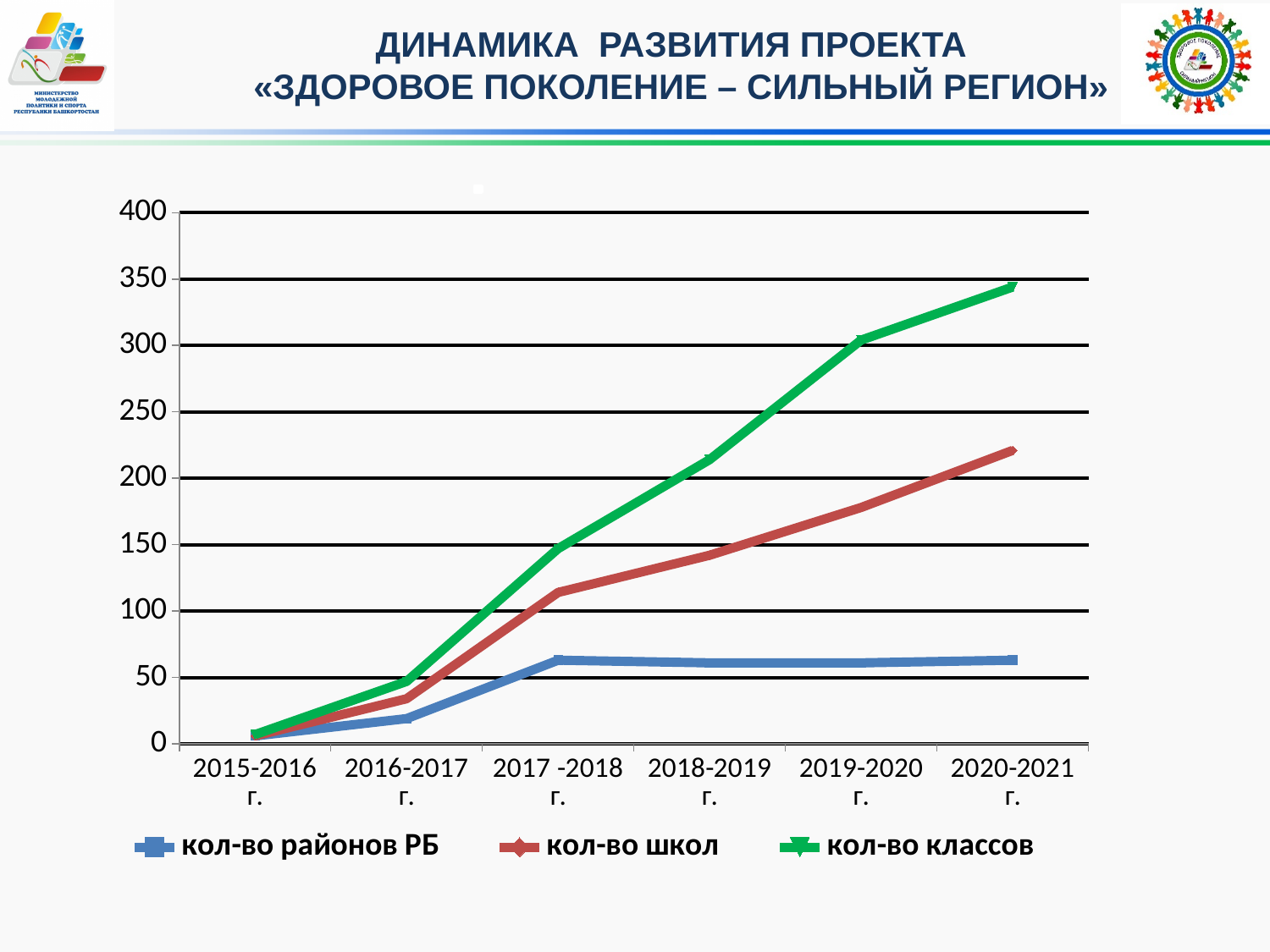
How many series does the legend list? 3 Which series has the lowest value in 2020-2021 г.? кол-во районов РБ What kind of chart is shown on the slide? line chart Which series has the highest value in 2020-2021 г.? кол-во классов Is the value for кол-во классов in 2020-2021 г. greater or less than 300? greater Does the кол-во классов series rise or fall from 2015-2016 г. to 2020-2021 г.? rise Which is larger in 2019-2020 г., кол-во школ or кол-во районов РБ? кол-во школ How many time periods are shown on the x axis? 6 In which period does кол-во классов reach its highest value? 2020-2021 г. Is the value for кол-во школ in 2020-2021 г. greater or less than 200? greater Is the value for кол-во районов РБ in 2020-2021 г. greater or less than 100? less